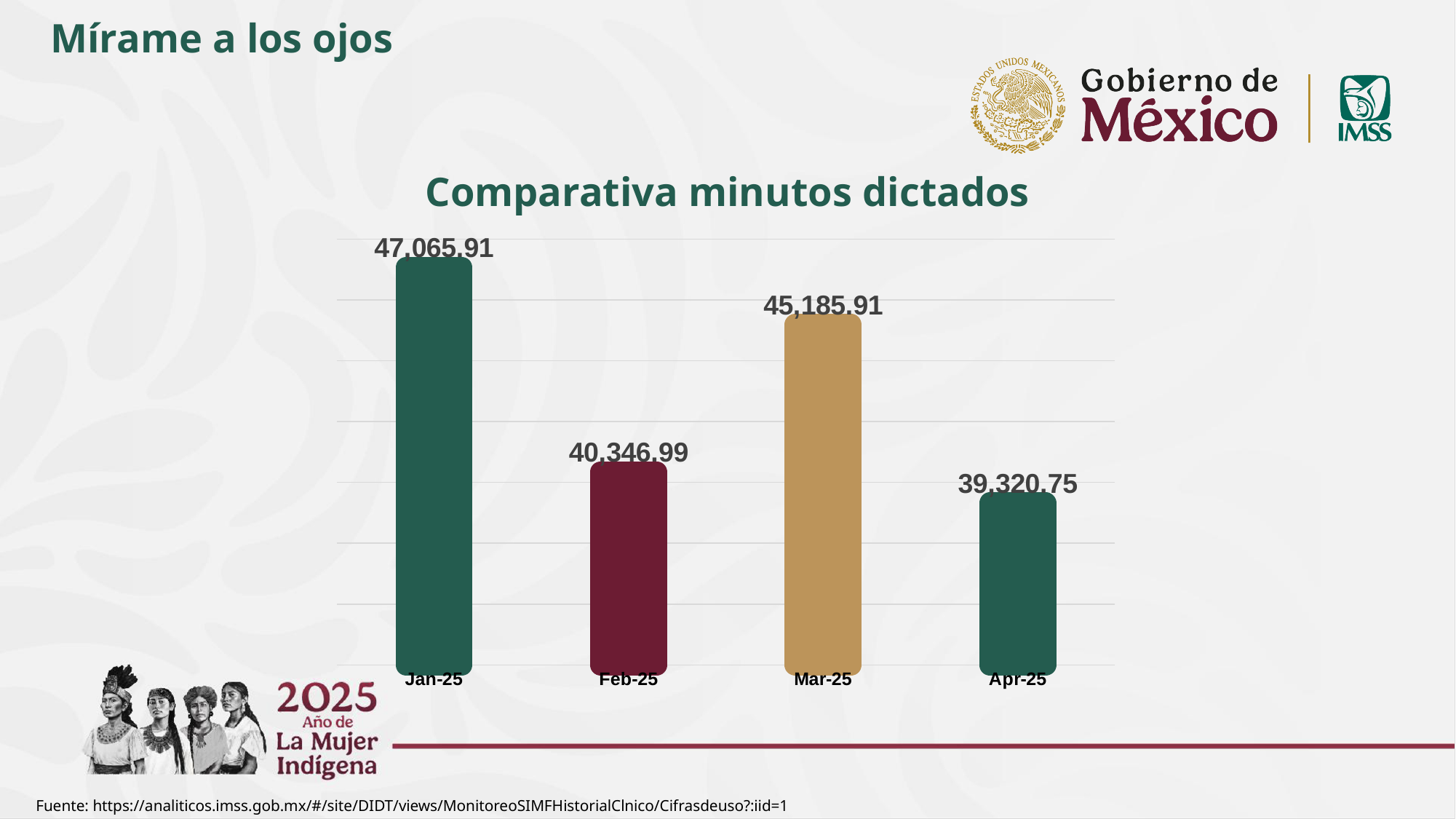
What is the value for Mar-25? 45,185.91 What is the title of the chart? Comparativa minutos dictados What kind of chart is shown on the slide? Bar chart What is the value for Jan-25? 47,065.91 How many months are shown in the chart? 4 Which month has the highest value? Jan-25 What is the difference between the values for Jan-25 and Feb-25? 6,718.92 Which month has the lowest value? Apr-25 Which is larger, the value for Feb-25 or the value for Mar-25? Mar-25 What is the difference between the values for Mar-25 and Apr-25? 5,865.16 What is the value for Feb-25? 40,346.99 What is the value for Apr-25? 39,320.75